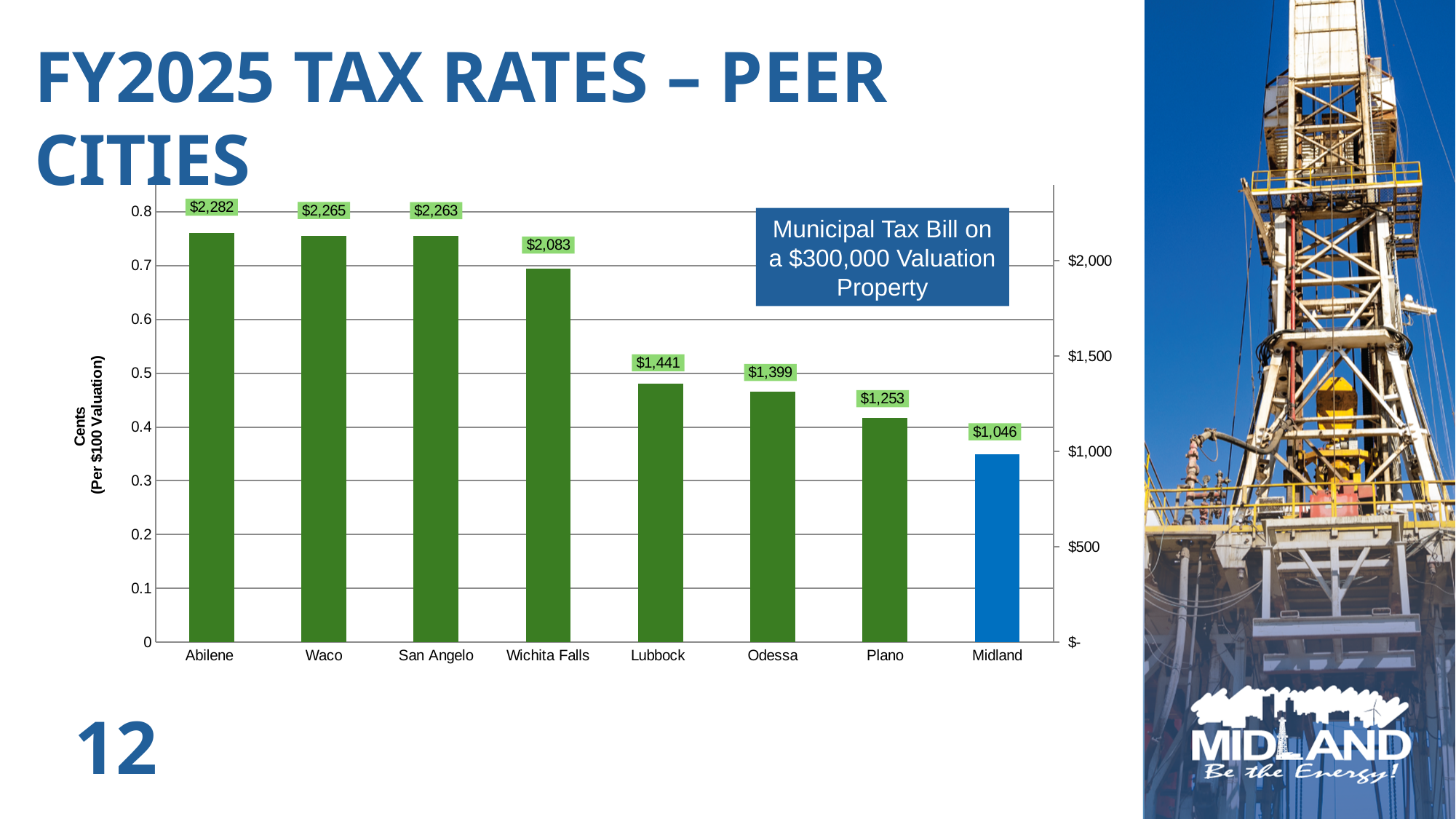
Which city has the lowest labelled municipal tax bill? Midland On the left axis (cents per $100 valuation), is the bar for Midland greater or less than 0.4? less Which has a larger labelled tax bill, Wichita Falls or Lubbock? Wichita Falls What kind of chart is shown on the slide? bar chart What is the difference between the labelled tax bills for Lubbock and Odessa? $42 What is the municipal tax bill label shown for Plano? $1,253 What is the municipal tax bill label shown for Abilene? $2,282 What is the municipal tax bill label shown for Wichita Falls? $2,083 How many cities are shown on the x axis of the chart? 8 What is the difference between the labelled tax bills for Abilene and Midland? $1,236 Which city has the highest labelled municipal tax bill? Abilene Do the bar values rise or fall moving from Abilene on the left to Midland on the right? fall